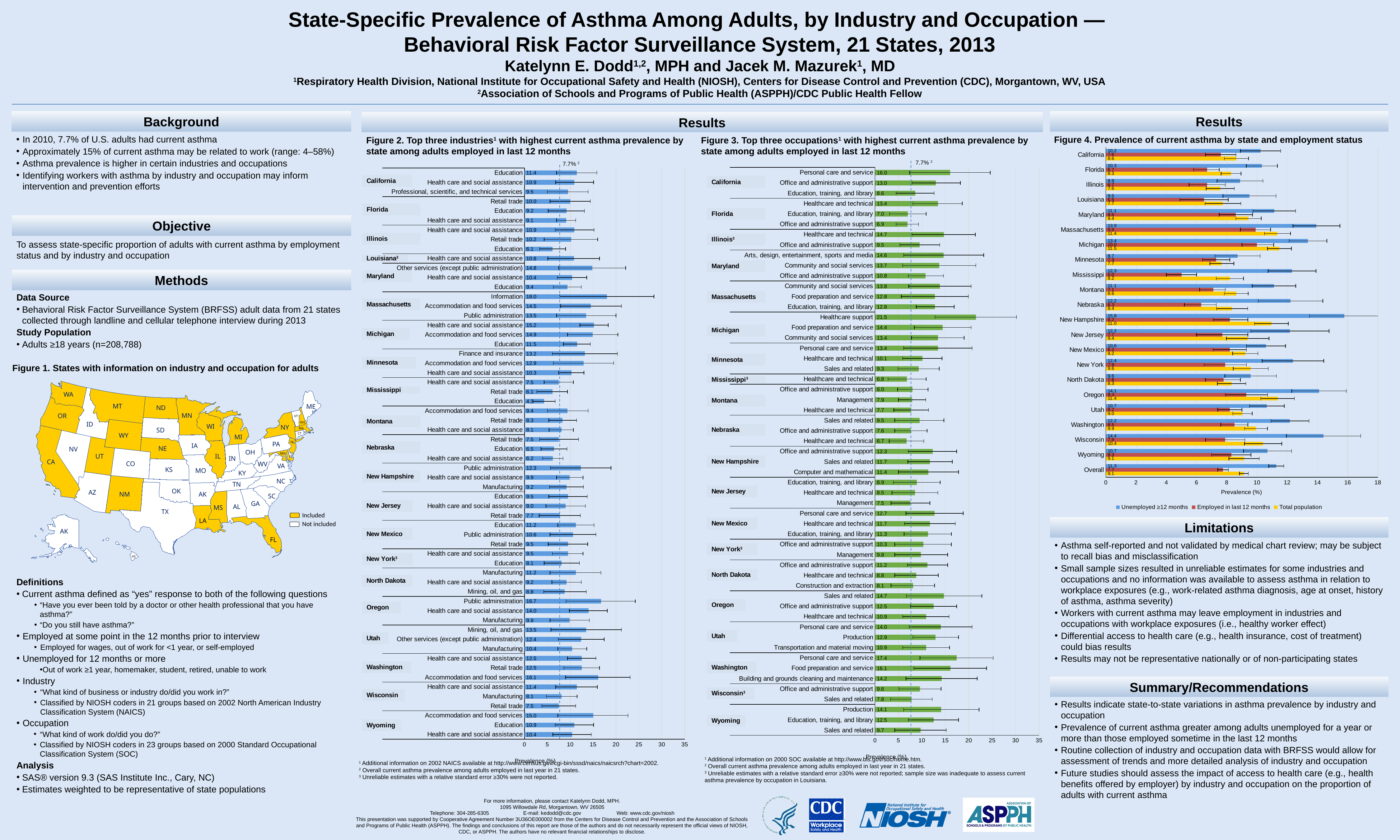
In Figure 3, what overall prevalence value is marked by the dashed reference line? 7.7% In Figure 4, how many series does the legend list? 3 In Figure 3, what is the current asthma prevalence for Healthcare support in Michigan? 21.5 In Figure 3, which state and occupation has the lowest prevalence value shown? Nebraska, Healthcare and technical (6.7) In Figure 2, which is larger: the Accommodation and food services value for Washington or for Wyoming? Washington (16.1) In Figure 2, which state and industry bar has the highest current asthma prevalence? Massachusetts, Information (18.0) In Figure 2, what is the difference between the Public administration value for Oregon and the Public administration value for New Hampshire? 4.4 In Figure 4, which state has the highest prevalence among adults unemployed ≥12 months? New Hampshire (15.8) In Figure 2, what is the current asthma prevalence for the Education industry in California? 11.4 In Figure 3, what is the difference between the Personal care and service value for Washington and for Utah? 3.4 In Figure 4, what is the Overall prevalence for adults unemployed ≥12 months? 11.3 In Figure 2, what is the lowest prevalence value shown, and for which state and industry? 4.3, Mississippi, Education